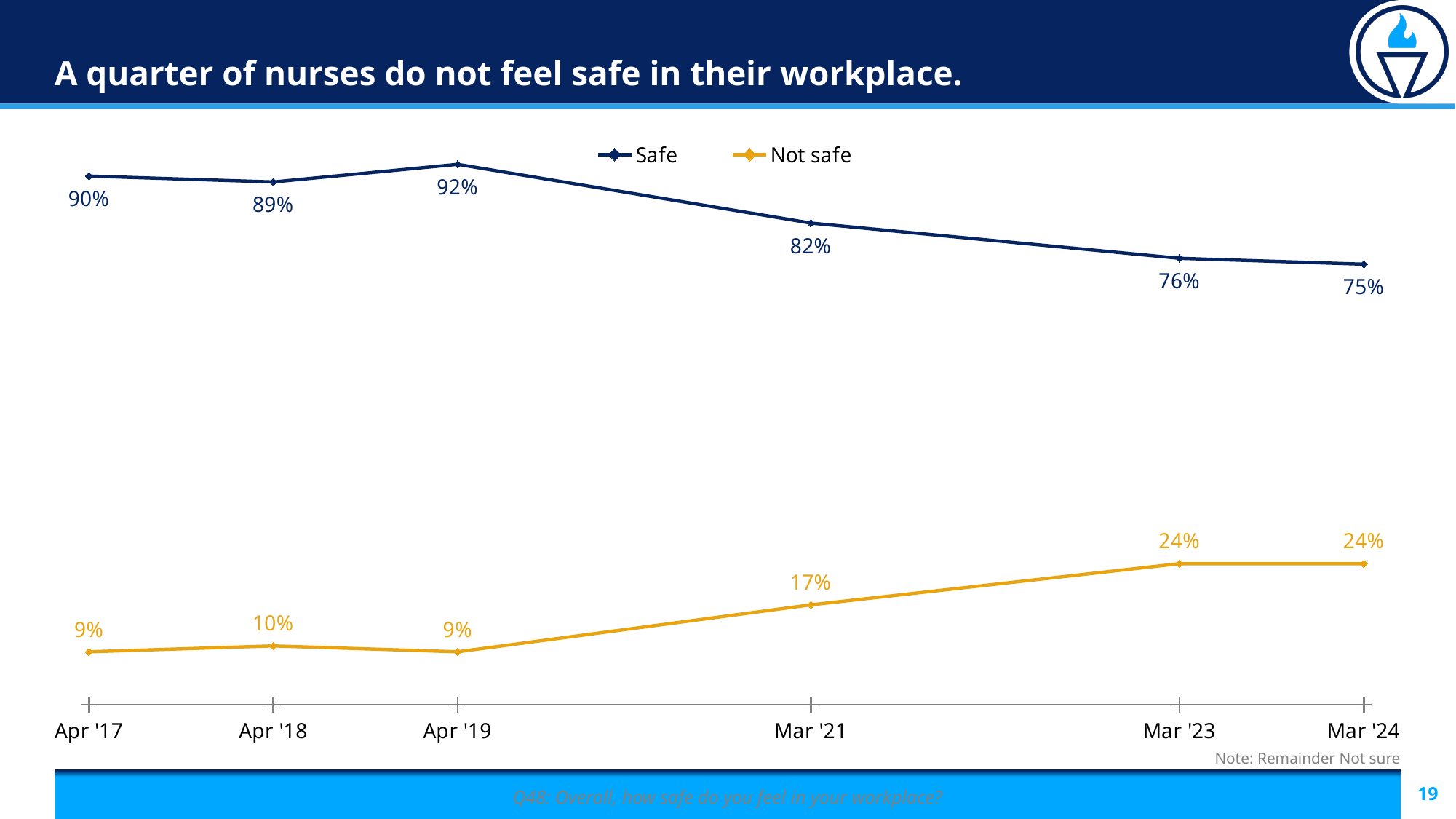
Does the Not safe series rise or fall from Apr '19 to Mar '24? Rise What is the Not safe value for Mar '21? 17% How many series does the legend list? 2 Which is larger: the Not safe value for Apr '18 or for Mar '23? Mar '23 What is the Safe value for Mar '24? 75% What kind of chart is shown on the slide? Line chart What is the title of the slide? A quarter of nurses do not feel safe in their workplace. How many time periods are shown on the x axis? 6 What is the difference between the Safe values for Apr '17 and Mar '24? 15 percentage points What percentage of nurses felt safe in Apr '19? 92% In which period is the Safe series at its highest? Apr '19 In which period is the Not safe series at its lowest, excluding ties? Name the earliest period with the lowest value. Apr '17